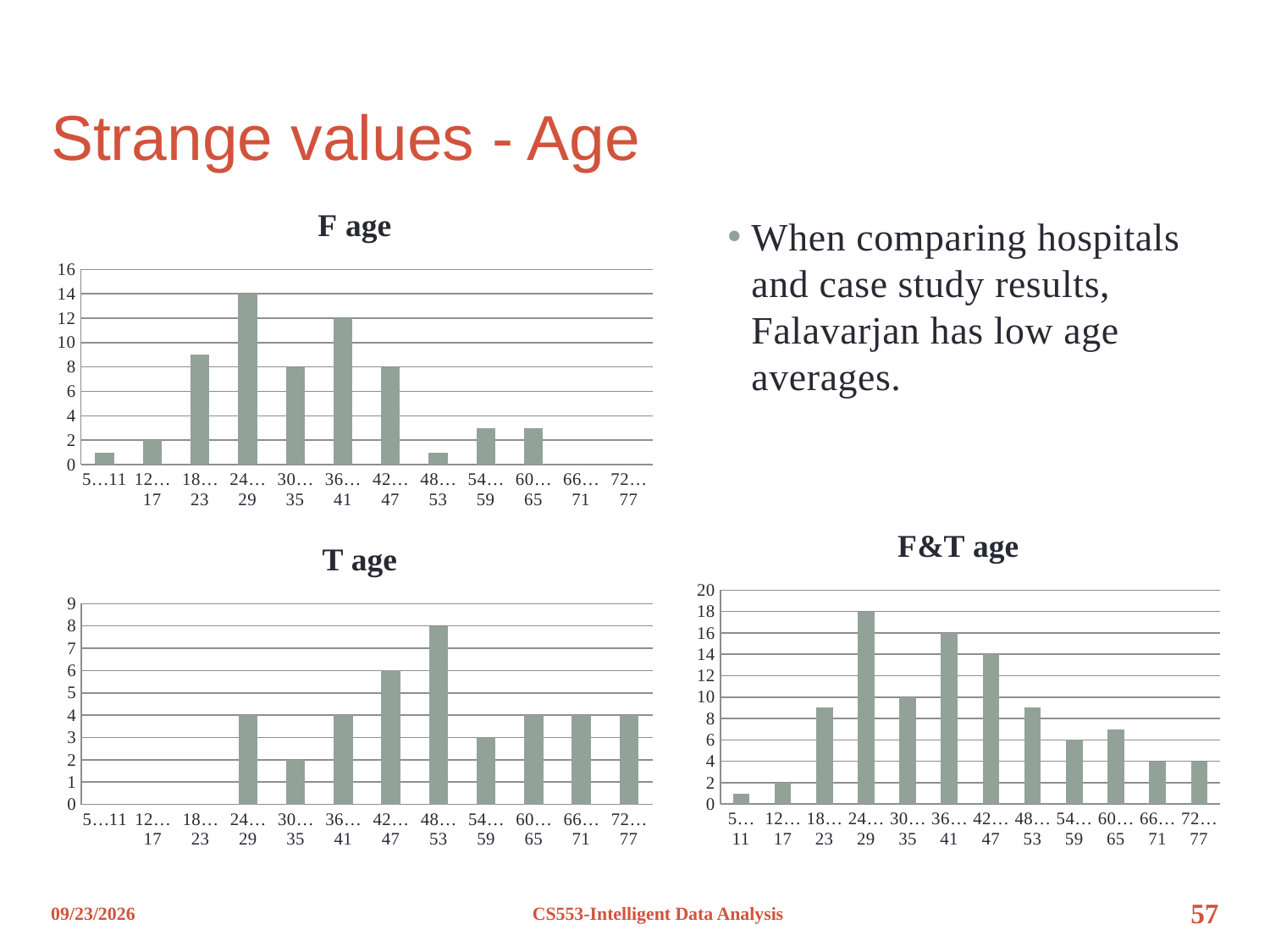
How many age groups are shown on the x axis of the F&T age chart? 12 In the F&T age chart, what is the difference between the values for 24…29 and 36…41? 2 In the F age chart, which age group has the highest bar? 24…29 In the T age chart, what is the value for the 30…35 age group? 2 In the F&T age chart, what is the value for the 24…29 age group? 18 In the T age chart, which age group has the highest bar? 48…53 In the T age chart, which is larger, the value for 42…47 or the value for 54…59? 42…47 In the T age chart, what is the value for the 42…47 age group? 6 In the F age chart, what is the value for the 24…29 age group? 14 What kind of chart is the F age chart? bar chart In the F age chart, what is the value for the 36…41 age group? 12 In the F age chart, is the value for the 18…23 age group greater or less than 8? greater